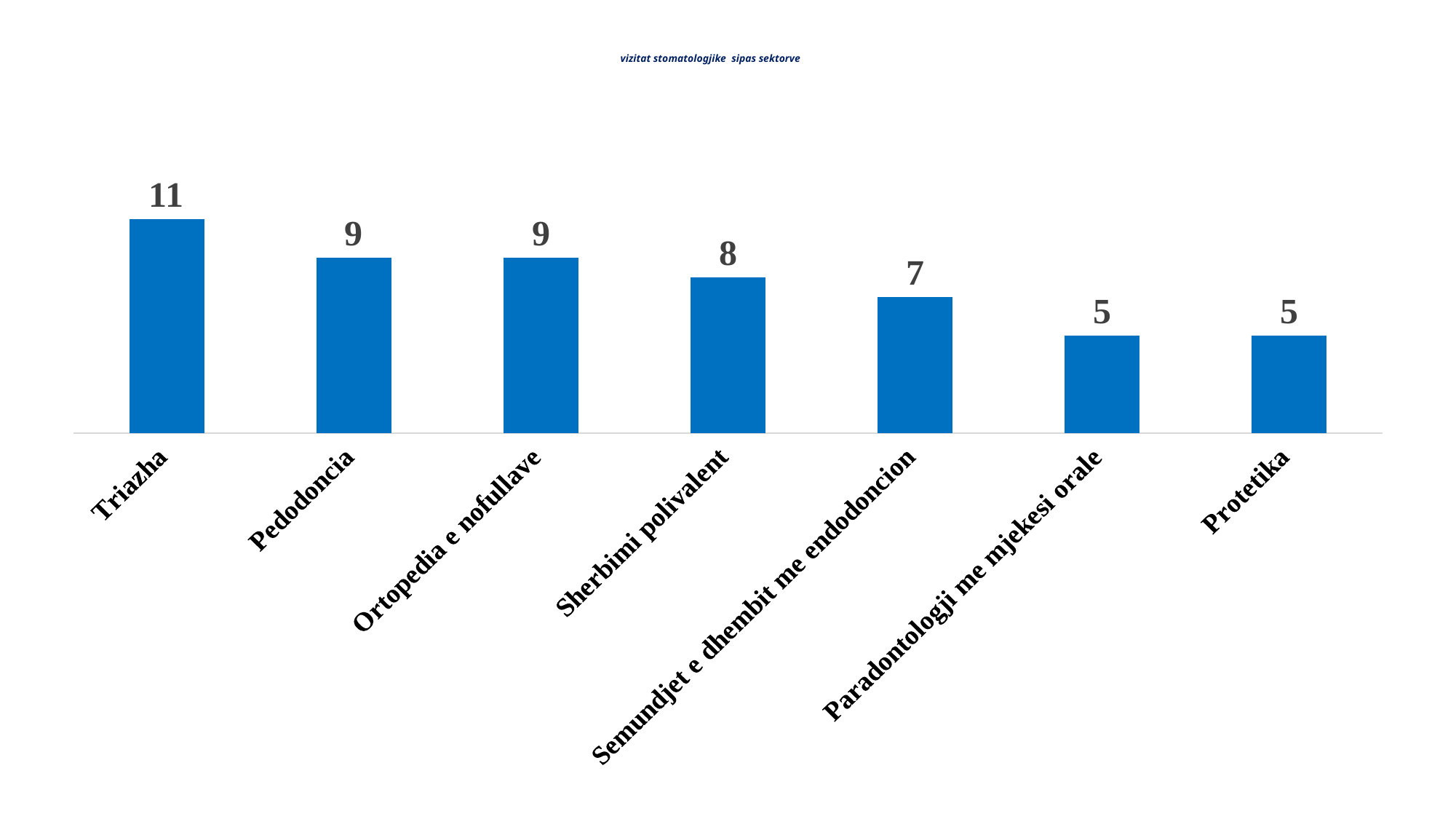
Which is larger, the value for Ortopedia e nofullave or the value for Semundjet e dhembit me endodoncion? Ortopedia e nofullave Do the values rise or fall from left to right along the x axis? Fall What is the title of the chart? vizitat stomatologjike sipas sektorve Which category has the highest value? Triazha What is the value for Sherbimi polivalent? 8 What is the difference between the values for Triazha and Pedodoncia? 2 What kind of chart is this? Bar chart What is the difference between the values for Sherbimi polivalent and Protetika? 3 How many categories are shown in the chart? 7 What is the value for Protetika? 5 What is the value for Semundjet e dhembit me endodoncion? 7 What is the value for Triazha? 11